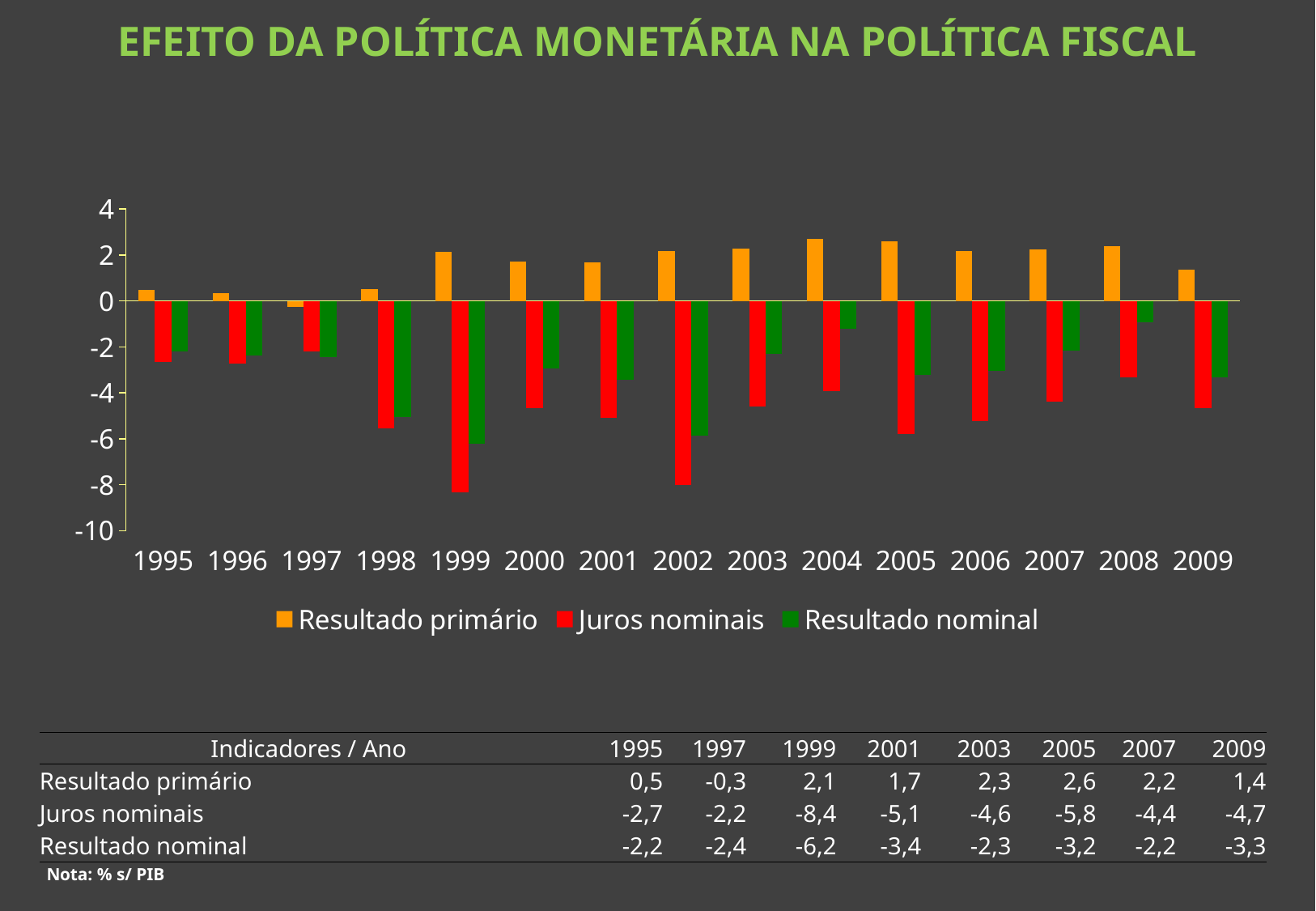
What is the value of Resultado primário in 2005? 2,6 What is the value of Juros nominais in 1999? -8,4 What is the difference between Resultado primário in 2005 and in 2009? 1,2 Between 2005 and 2008, do the Juros nominais bars rise or fall? rise Is the value for Juros nominais in 2002 greater or less than -6? less According to the table, in which year was Juros nominais lowest? 1999 What is the value of Resultado nominal in 2001? -3,4 Which is larger, Juros nominais in 1999 or in 2001? 2001 What kind of chart is shown on the slide? bar chart How many series does the chart legend list? 3 How many years are shown on the x axis of the chart? 15 What colour are the Juros nominais bars? red